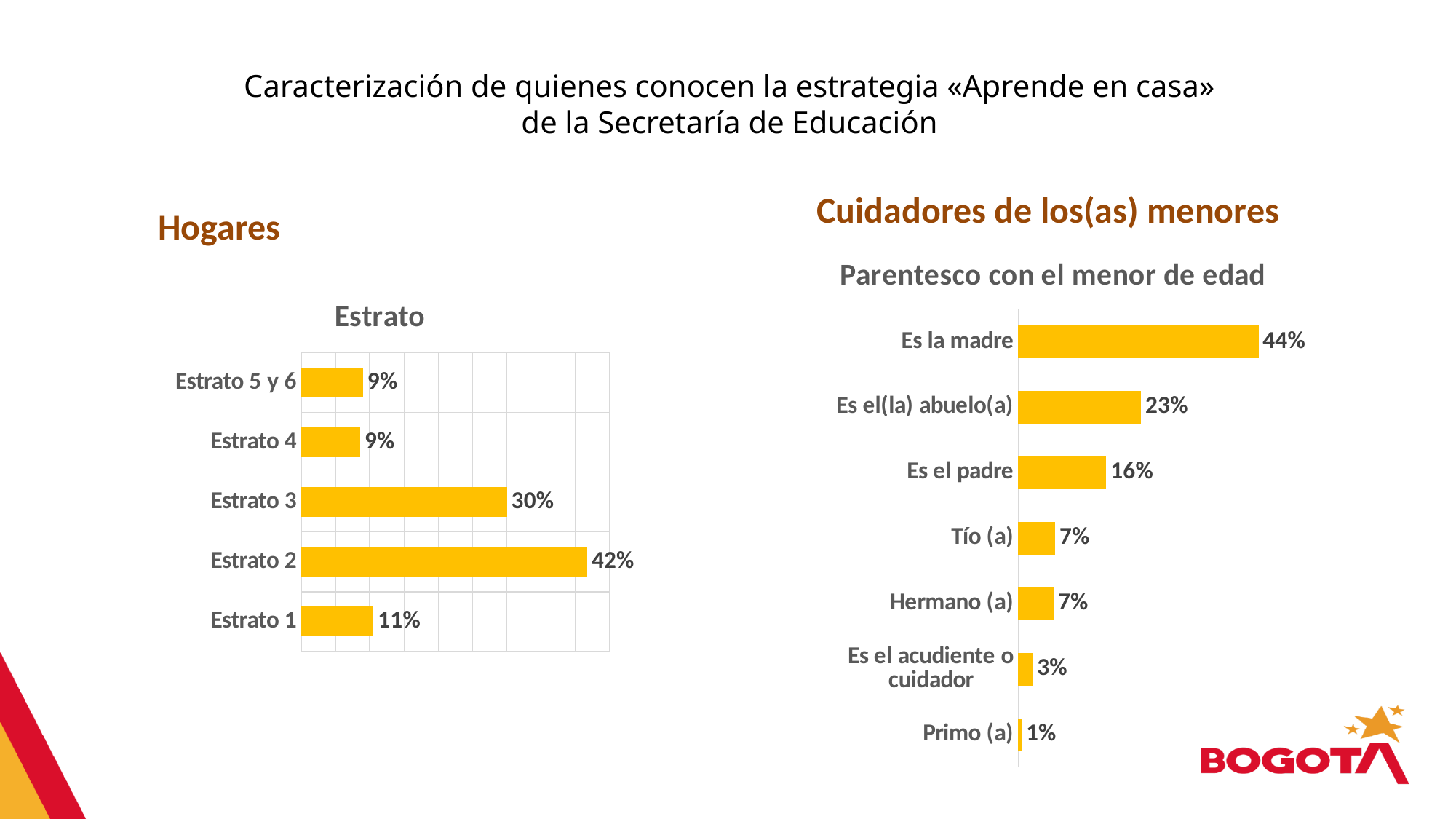
In the "Estrato" chart, what is the difference between Estrato 2 and Estrato 3? 12% In the "Parentesco con el menor de edad" chart, what is the value for Es el padre? 16% In the "Estrato" chart, how many categories are shown? 5 In the "Parentesco con el menor de edad" chart, what is the difference between Es la madre and Es el(la) abuelo(a)? 21% In the "Parentesco con el menor de edad" chart, which is larger: Es el padre or Tío (a)? Es el padre In the "Estrato" chart, which category has the highest value? Estrato 2 What type of chart is the "Estrato" chart? Bar chart In the "Parentesco con el menor de edad" chart, how many categories are shown? 7 In the "Parentesco con el menor de edad" chart, which category has the lowest value? Primo (a) In the "Parentesco con el menor de edad" chart, which category has the highest value? Es la madre In the "Estrato" chart, what is the value for Estrato 2? 42% In the "Estrato" chart, what is the value for Estrato 1? 11%